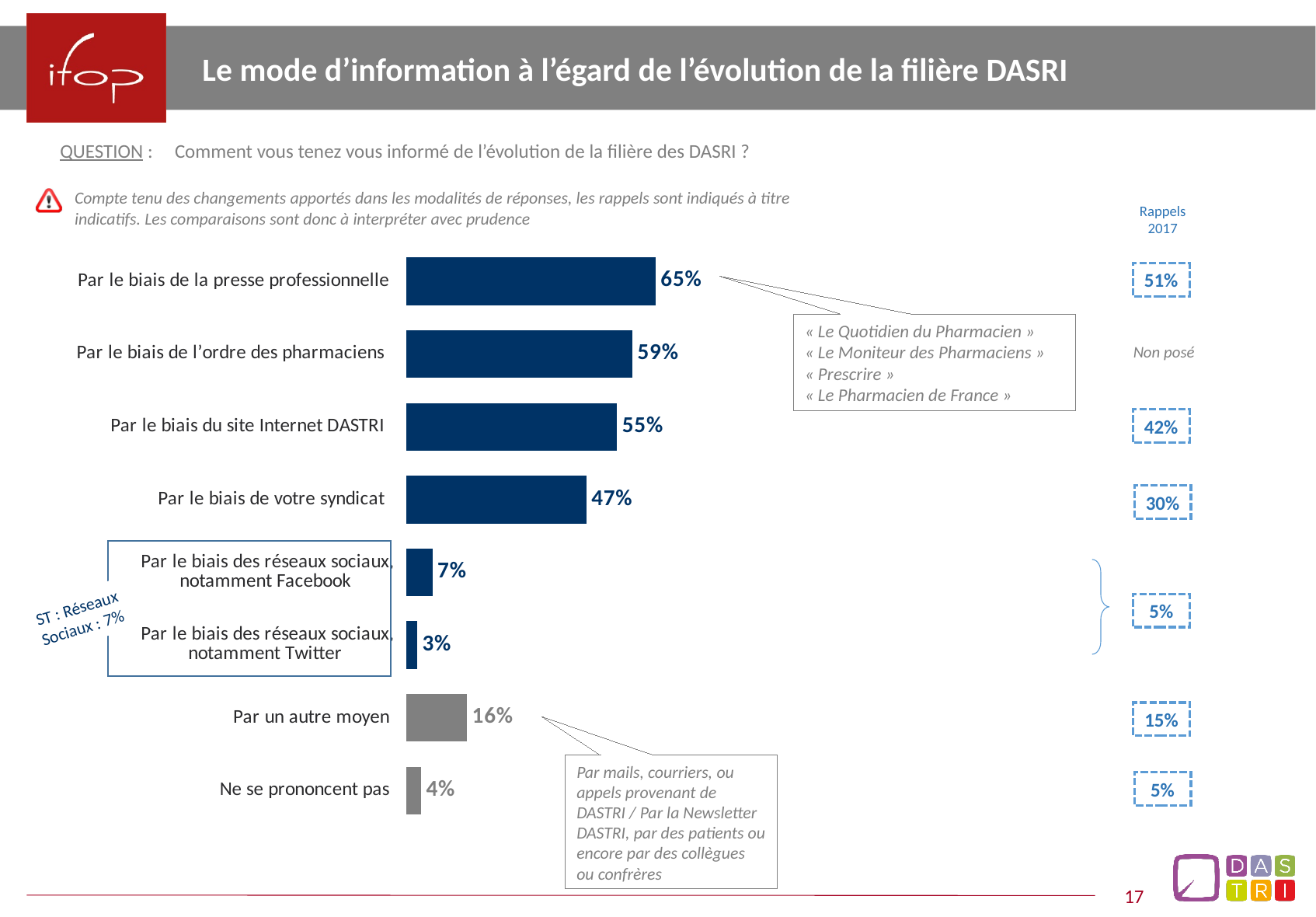
What is the difference between the values for "Par le biais de l'ordre des pharmaciens" and "Par le biais de votre syndicat"? 12 points What is the sub-total shown for social networks ("ST : Réseaux Sociaux")? 7% Which category has the lowest value in the bar chart? Par le biais des réseaux sociaux, notamment Twitter What is the 2017 recall value ("Rappels 2017") shown for "Par le biais du site Internet DASTRI"? 42% What kind of chart is shown on the slide? Bar chart What is the 2017 recall value shown for "Par le biais de l'ordre des pharmaciens"? Non posé What is the value shown for "Par le biais du site Internet DASTRI"? 55% Which category has the highest value in the bar chart? Par le biais de la presse professionnelle How many categories are plotted in the bar chart? 8 What percentage of respondents say they keep informed via the professional press ("Par le biais de la presse professionnelle")? 65% Which is larger: the value for "Par un autre moyen" or the value for "Par le biais des réseaux sociaux, notamment Facebook"? Par un autre moyen What is the value shown for "Par le biais des réseaux sociaux, notamment Twitter"? 3%